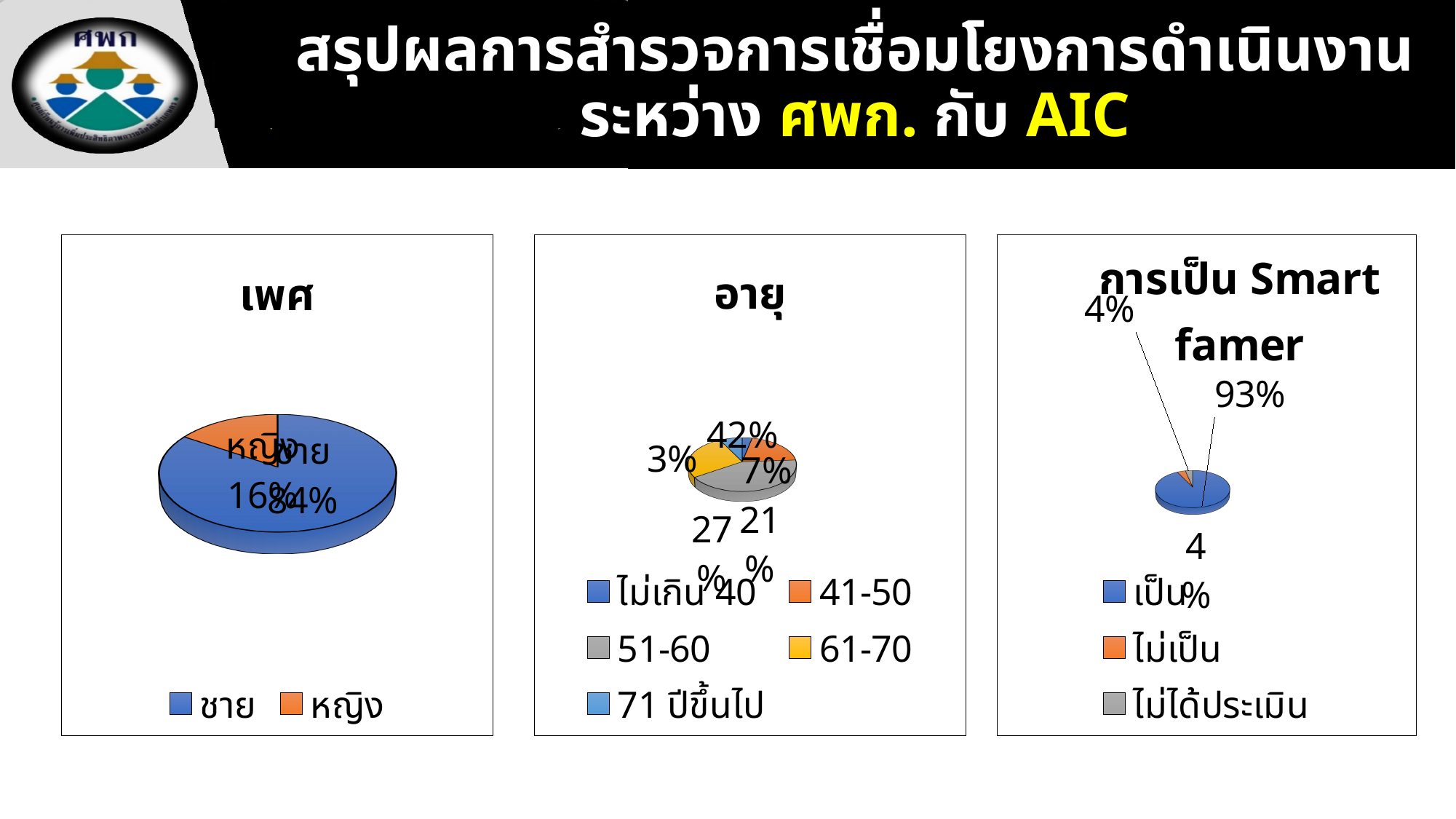
How many categories does the legend of the "อายุ" chart list? 5 In the "เพศ" chart, what is the difference between the shares of ชาย and หญิง? 68 percentage points How many categories does the legend of the "การเป็น Smart famer" chart list? 3 In the "เพศ" chart, what is the value for หญิง? 16% How many charts are shown on the slide? 3 What kind of chart is the "อายุ" chart in the middle? pie chart How many categories does the legend of the "เพศ" chart list? 2 In the "เพศ" chart, what is the value for ชาย? 84% In the "เพศ" chart, which category has the largest share? ชาย In the "การเป็น Smart famer" chart, what is the value for เป็น? 93% What kind of chart is the "เพศ" chart on the left? pie chart In the "การเป็น Smart famer" chart, which category has the largest share? เป็น